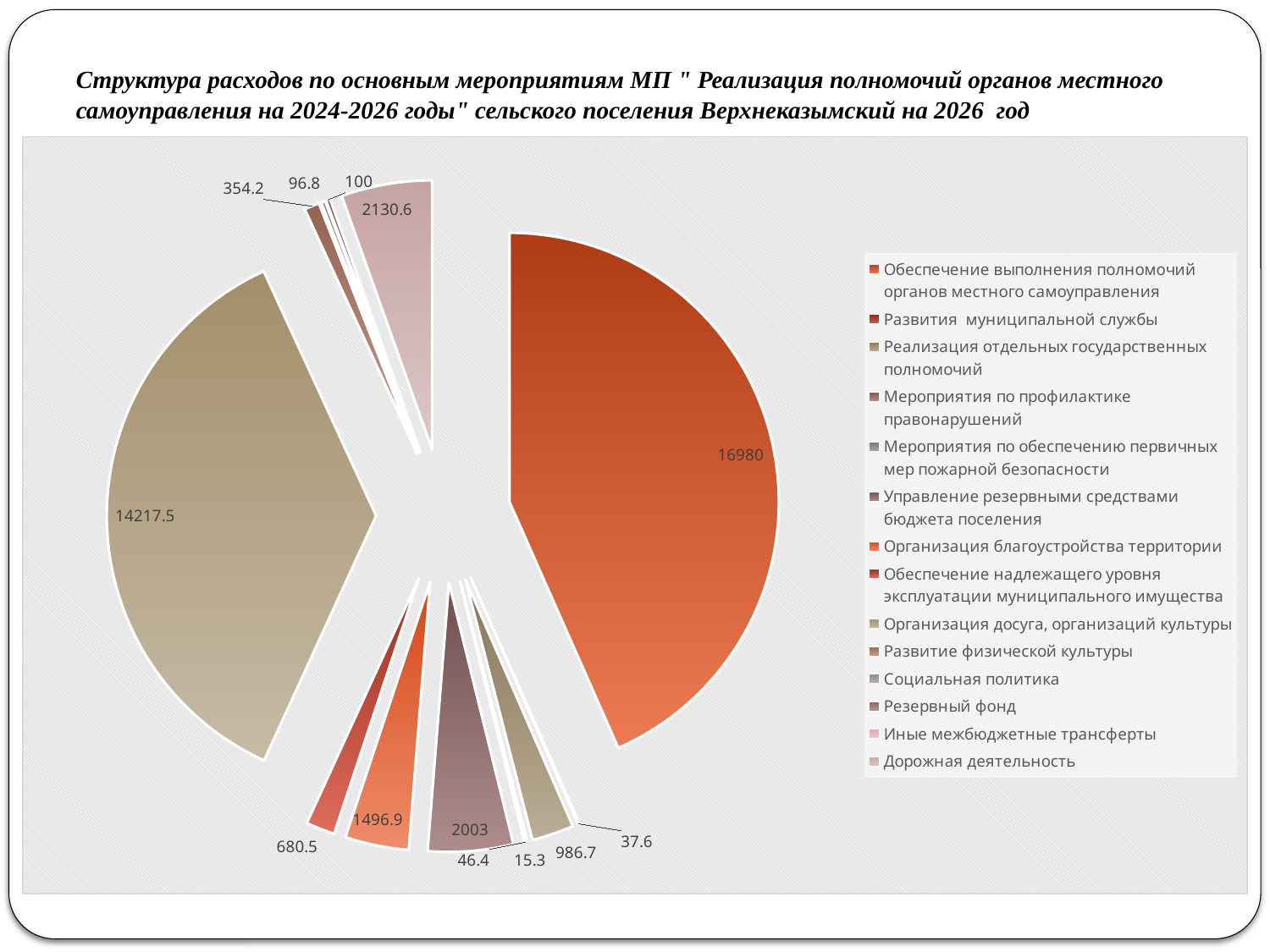
For which year does the chart title say the expenditure structure is shown? 2026 What is the value shown for the largest slice of the pie chart? 16980 What is the difference between the two largest slices, 16980 and 14217.5? 2762.5 What is the value shown for Организация досуга, организаций культуры? 14217.5 What is the smallest value printed as a data label on the pie chart? 15.3 What is the value shown for Управление резервными средствами бюджета поселения? 2003 What kind of chart is shown on the slide? Pie chart How many categories does the legend of the pie chart list? 14 Which category has the largest slice in the pie chart? Обеспечение выполнения полномочий органов местного самоуправления What is the value shown for Дорожная деятельность? 2130.6 Which is larger: the slice for Организация благоустройства территории or the slice for Дорожная деятельность? Дорожная деятельность What is the value shown for Организация благоустройства территории? 1496.9